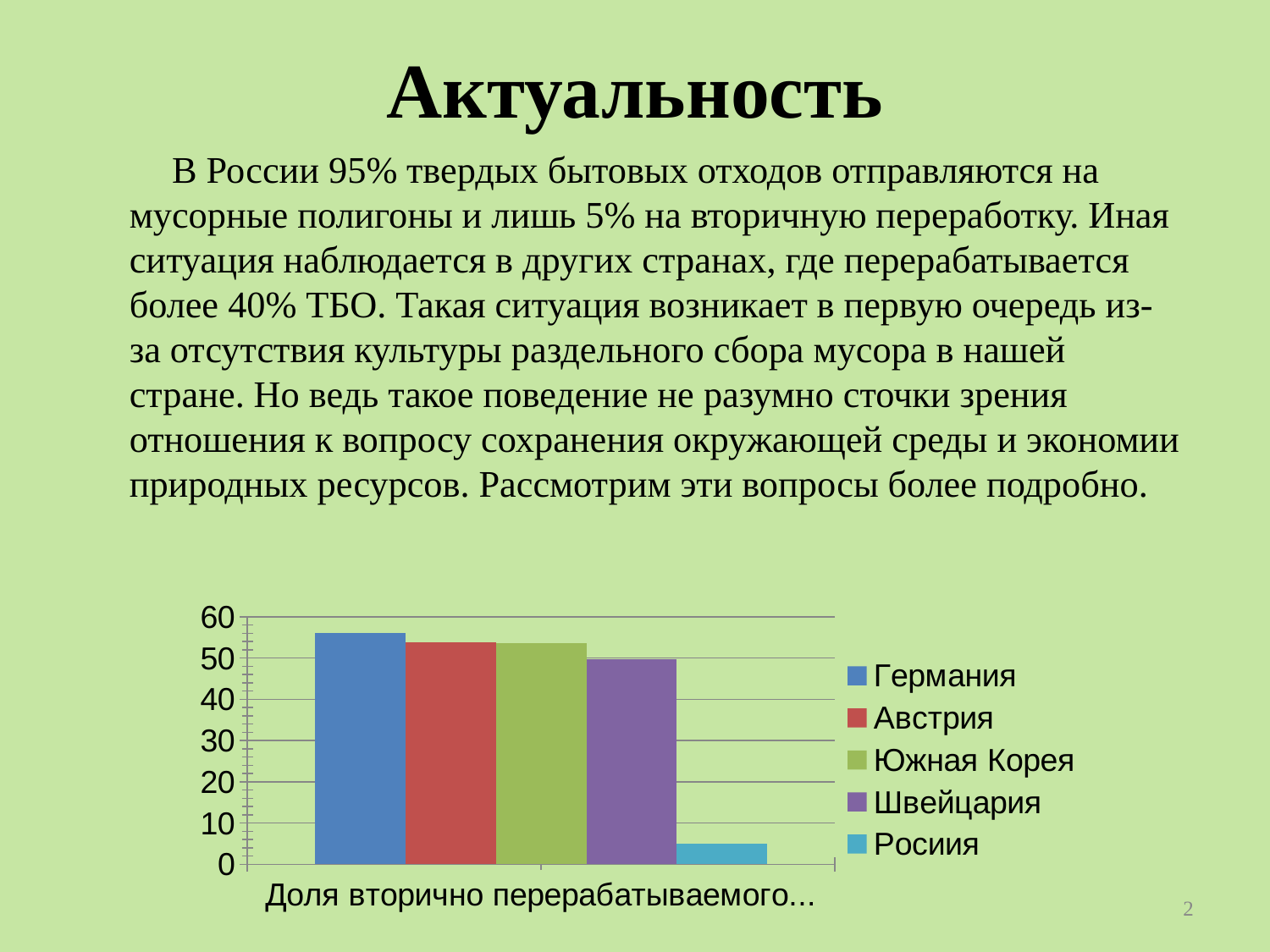
Which country has the lowest bar? Росиия What kind of chart is shown on the slide? bar chart Is the value for Швейцария greater or less than 40? greater Is the value for Росиия greater or less than 10? less Which colour represents Южная Корея in the legend? green Which country has the highest bar? Германия How many series does the legend list? 5 What is the highest tick value shown on the vertical axis? 60 How many categories are shown on the x axis? 1 Which is larger, the value for Швейцария or the value for Росиия? Швейцария Is the value for Германия greater or less than 50? greater